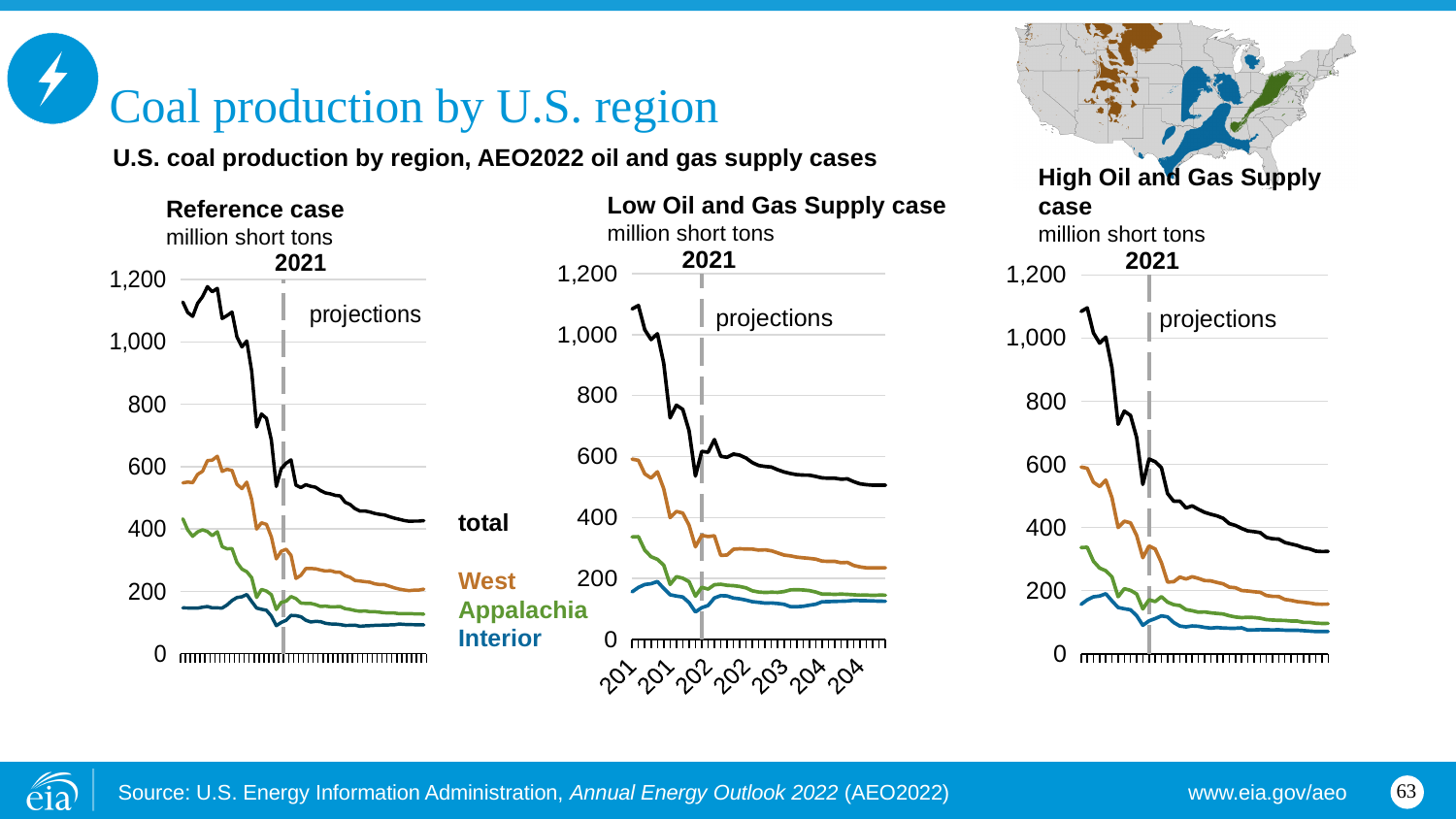
What kind of chart is the Reference case chart? line chart In the Reference case chart, is the total value at the start of the series greater or less than 1,000? greater What unit of measurement is shown on the coal production charts? million short tons In the Reference case chart, which series has the highest values throughout? total In the High Oil and Gas Supply case chart, is the total value at the end of the projection period greater or less than 400? less In the High Oil and Gas Supply case chart, is the West value at the end of the projection period greater or less than 200? less In the Low Oil and Gas Supply case chart, which series has the lowest values at the end of the projection period? Interior Which year is marked by the dashed vertical line separating history from projections? 2021 How many series does the legend list for the coal production charts? 4 In the High Oil and Gas Supply case chart, does the total coal production rise or fall over the projection period? fall In the Reference case chart, which is larger at the end of the projection period, West or Appalachia? West